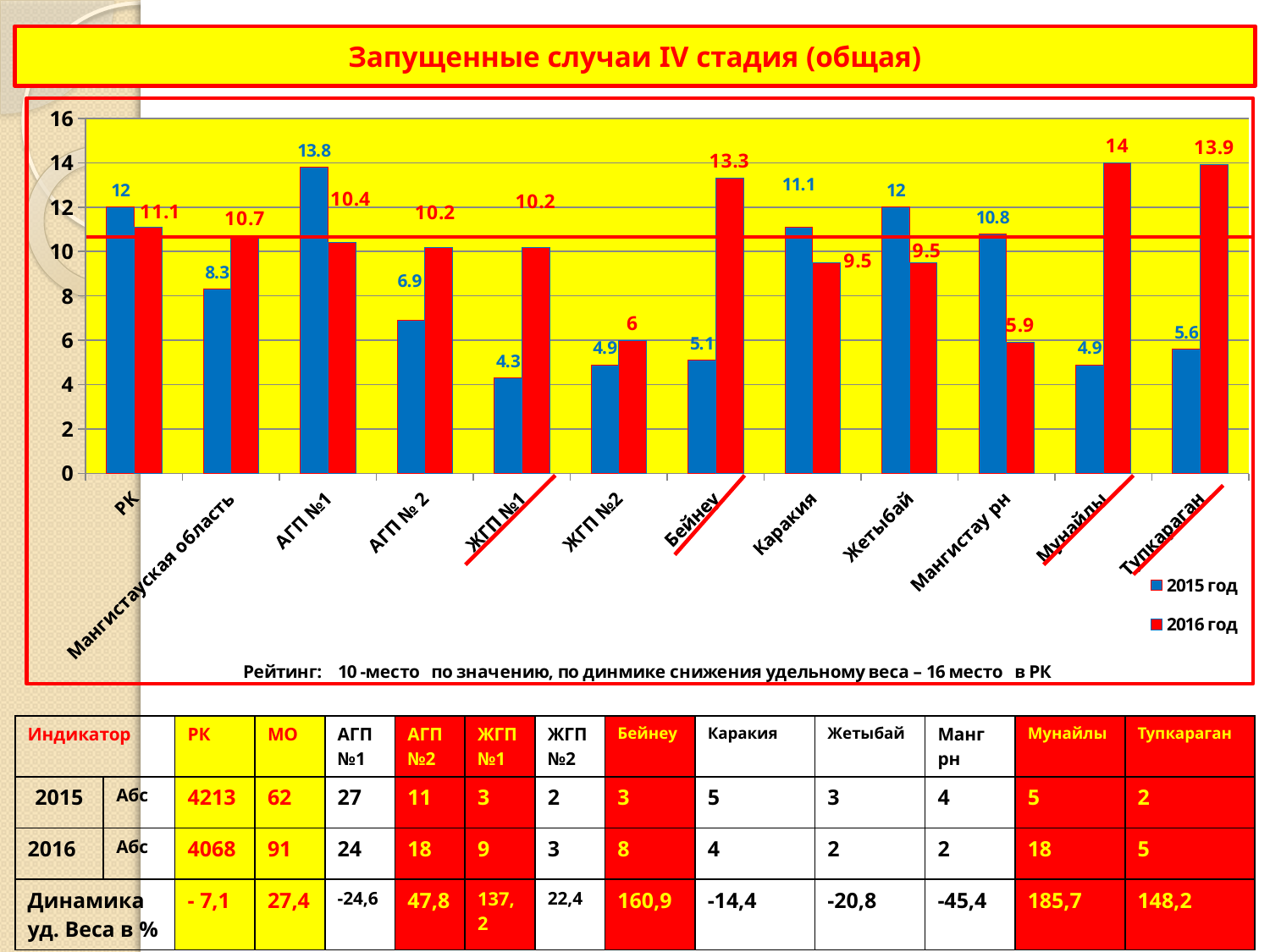
How many categories are shown on the x axis of the chart? 12 Which category has the highest 2015 год value? АГП №1 What is the 2016 год value for Мангистау рн? 5.9 How many series does the chart legend list? 2 Which category has the lowest 2016 год value? Мангистау рн What is the difference between the 2016 год and 2015 год values for Мунайлы? 9.1 What is the title of the chart? Запущенные случаи IV стадия (общая) Which category has the lowest 2015 год value? ЖГП №1 What is the 2016 год value for Бейнеу? 13.3 For Жетыбай, which is larger: the 2015 год value or the 2016 год value? 2015 год What type of chart is shown on the slide? bar chart What is the 2015 год value for АГП №1? 13.8